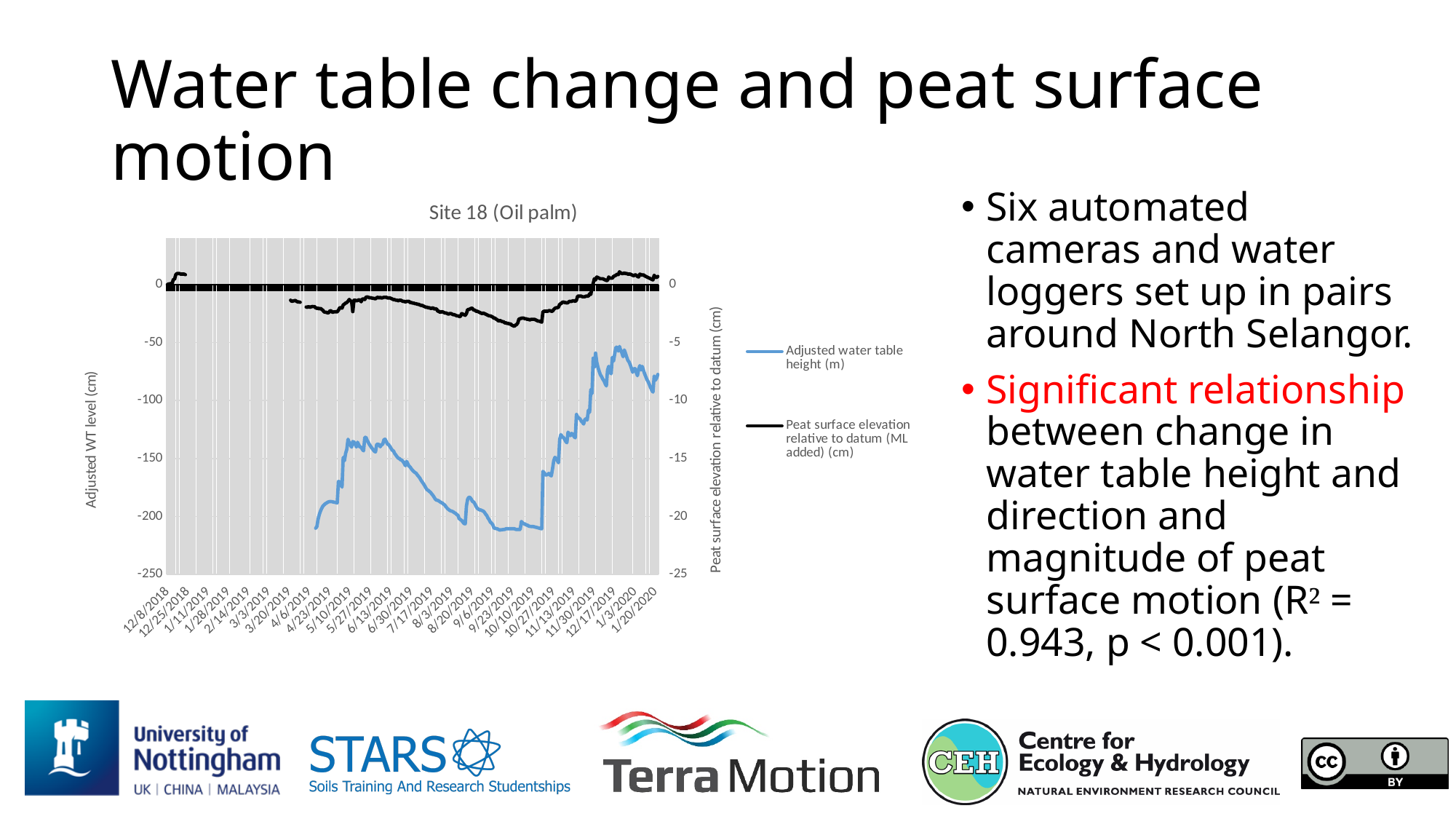
Does the peat surface elevation rise or fall between 10/10/2019 and 12/17/2019? rise What kind of chart is shown on the slide? line chart How many series does the chart legend list? 2 What is the title of the chart? Site 18 (Oil palm) Is the adjusted water table height around 4/23/2019 greater or less than -200 on the left axis? greater Which colour is used for the 'Adjusted water table height (m)' series? blue Is the peat surface elevation around 10/10/2019 greater or less than -5 on the right axis? greater Is the adjusted water table height around 5/10/2019 greater or less than -150 on the left axis? greater Does the adjusted water table height rise or fall between 5/27/2019 and 8/20/2019? fall Does the adjusted water table height rise or fall between 10/27/2019 and 12/17/2019? rise